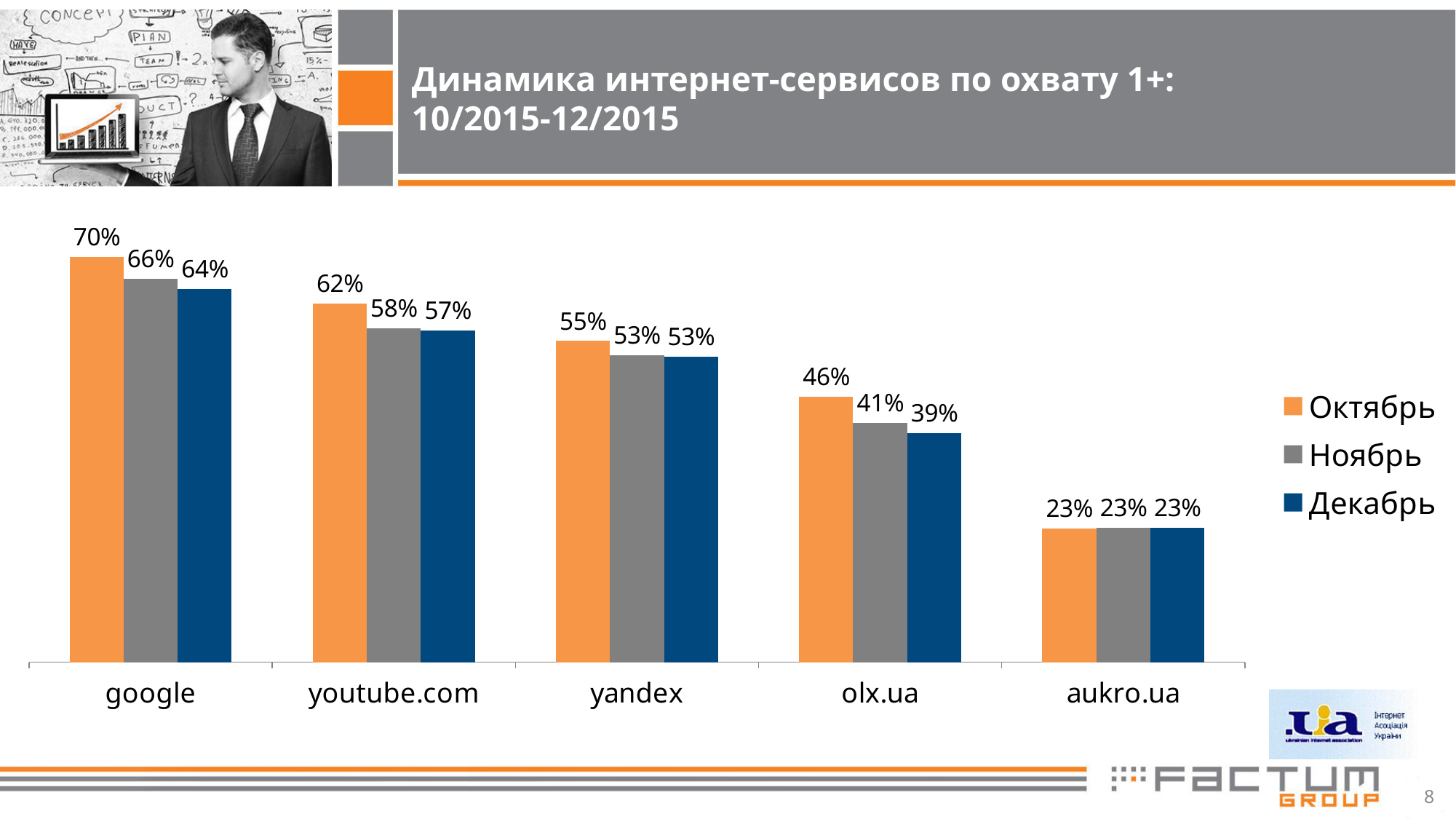
How many categories are shown on the x axis? 5 What is the value for olx.ua in Декабрь? 39% What is the difference between the Октябрь and Декабрь values for google? 6% Which is larger: the Ноябрь value for yandex or the Ноябрь value for olx.ua? yandex Which category has the lowest value in Декабрь? aukro.ua Do the Октябрь values rise or fall from google to aukro.ua along the x axis? fall What kind of chart is shown on the slide? bar chart How many series does the legend list? 3 What is the value for youtube.com in Ноябрь? 58% Which category has the highest value in Октябрь? google What is the difference between the Октябрь and Ноябрь values for olx.ua? 5% What is the value for google in Октябрь? 70%